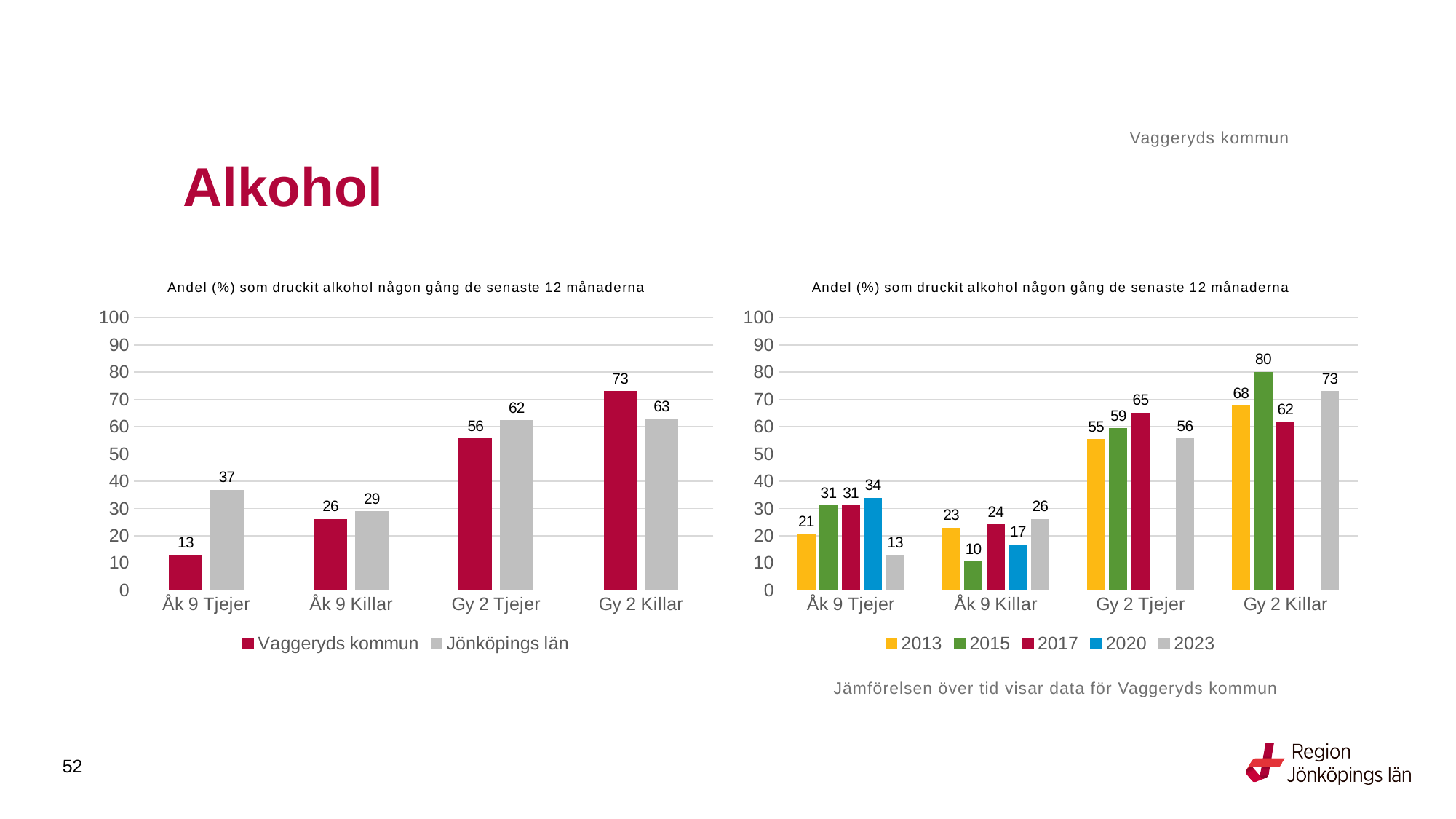
In the right chart, how many series does the legend list? 5 What kind of chart is the right chart? Bar chart In the left chart, how many series does the legend list? 2 In the right chart, what is the value for 2020 for Åk 9 Killar? 17 In the left chart, what is the value for Jönköpings län for Gy 2 Tjejer? 62 In the left chart, what is the difference between Jönköpings län and Vaggeryds kommun for Åk 9 Tjejer? 24 In the right chart, what is the difference between the 2017 and 2013 values for Gy 2 Tjejer? 10 In the left chart, what is the value for Vaggeryds kommun for Åk 9 Tjejer? 13 In the left chart, which category has the highest value for Vaggeryds kommun? Gy 2 Killar In the right chart, what is the value for 2015 for Gy 2 Killar? 80 In the left chart, which is larger for Gy 2 Killar: Vaggeryds kommun or Jönköpings län? Vaggeryds kommun In the right chart, which year has the lowest value for Åk 9 Killar? 2015